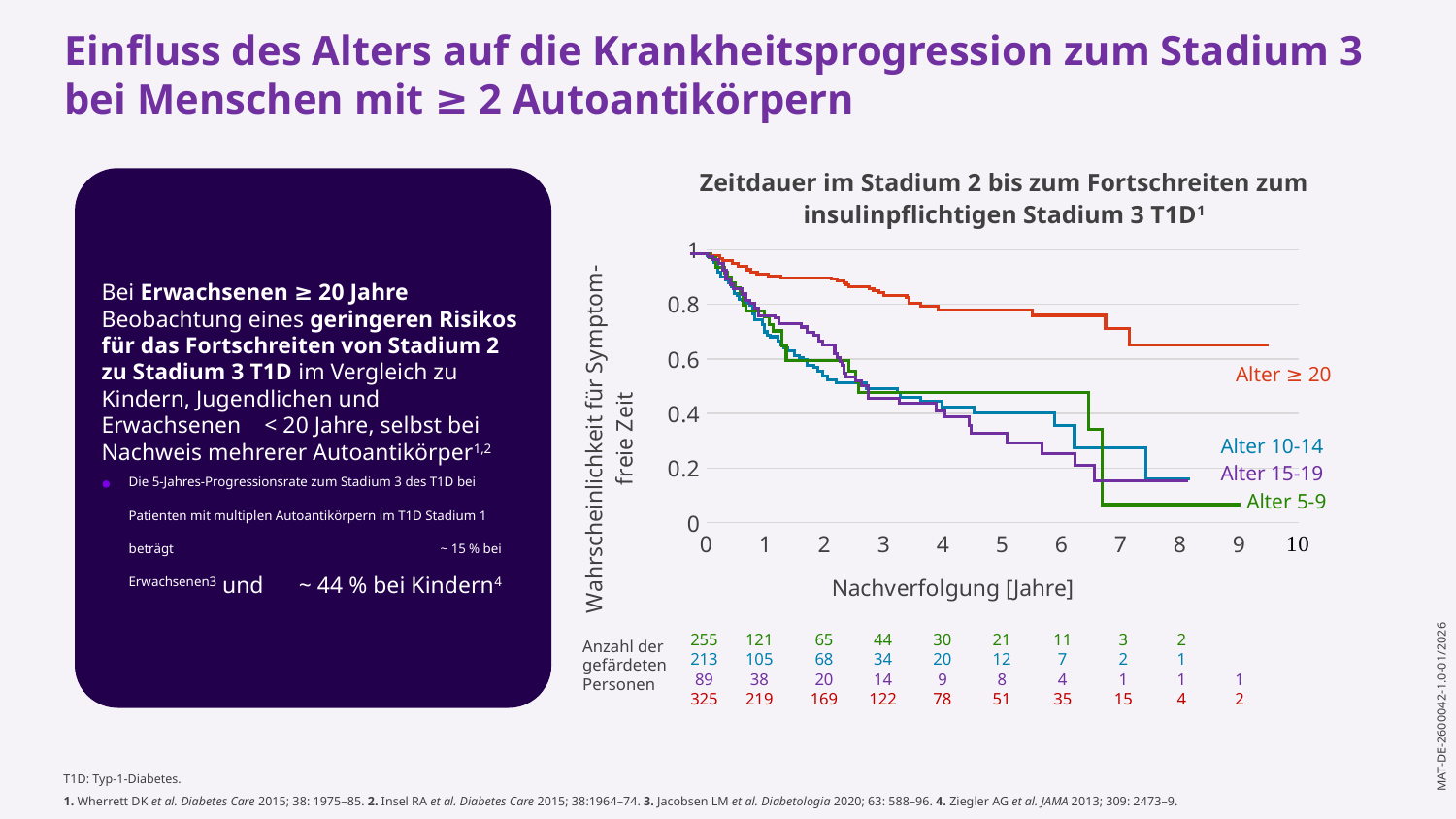
Which age group has the highest probability of symptom-free time at 8 years of follow-up? Alter ≥ 20 What is the label of the x axis of the chart? Nachverfolgung [Jahre] In the number-at-risk table, how many persons in the Alter ≥ 20 group are at risk at year 0? 325 Is the probability of symptom-free time for Alter ≥ 20 at 8 years greater or less than 0.6? greater Is the probability of symptom-free time for Alter 5-9 at 8 years greater or less than 0.2? less In the number-at-risk table, how many persons in the Alter 5-9 group are at risk at year 1? 121 Which age group has the lowest probability of symptom-free time at 8 years of follow-up? Alter 5-9 What kind of chart is shown on the slide? line chart How many age groups (series) are plotted in the chart? 4 Do the curves rise or fall as the follow-up time increases along the x axis? fall What is the title of the chart? Zeitdauer im Stadium 2 bis zum Fortschreiten zum insulinpflichtigen Stadium 3 T1D In the number-at-risk table, what is the difference between the number at risk at year 0 for Alter ≥ 20 and for Alter 5-9? 70